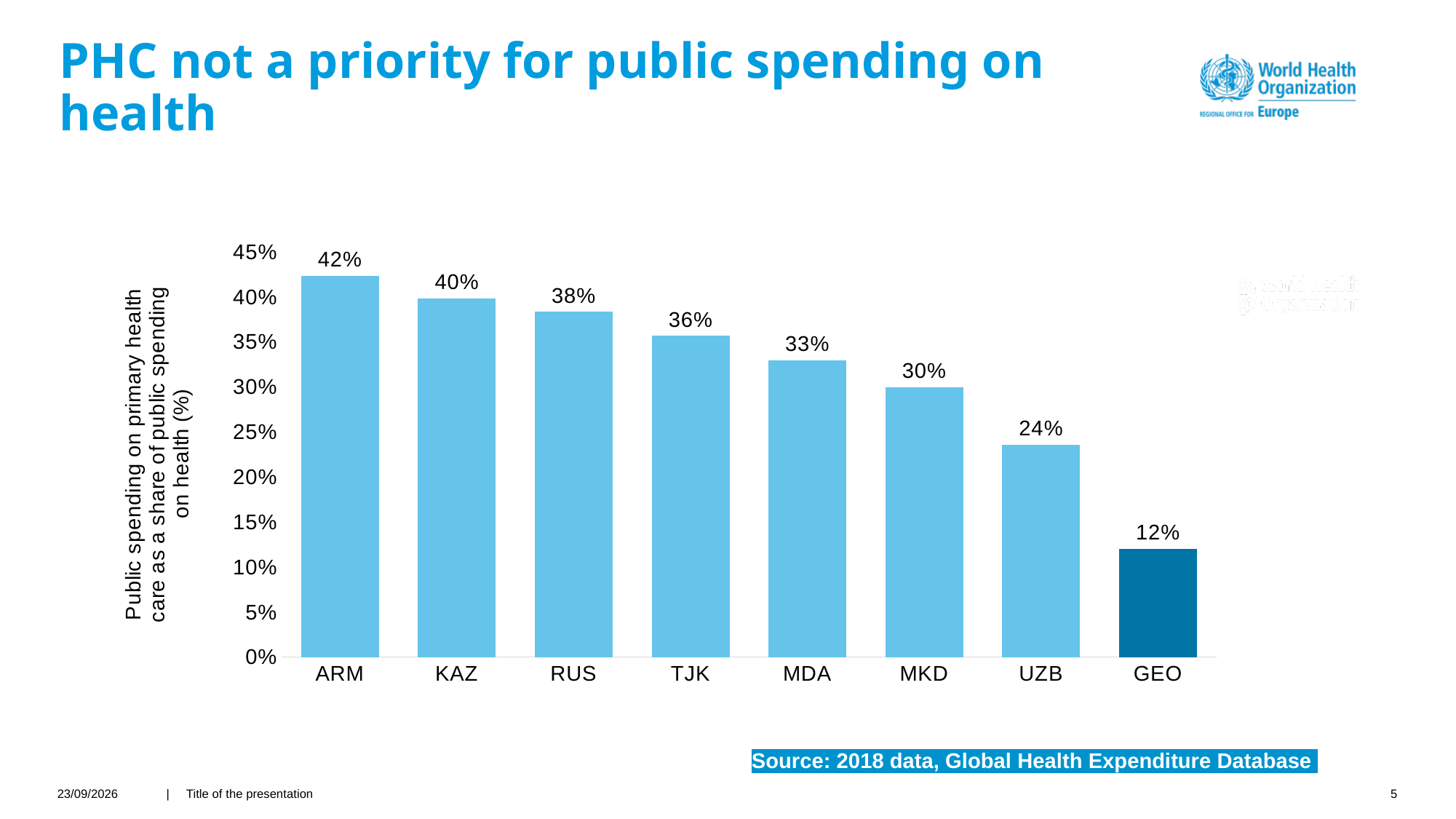
What kind of chart is shown on the slide? bar chart How many countries are shown on the chart? 8 Is the value for TJK greater or less than 35%? greater What is the value for MDA? 33% What is the value for GEO? 12% Which country has the highest value? ARM What is the difference between the values for KAZ and UZB? 16% What is the value for ARM? 42% Which country has the lowest value? GEO Which bar is shown in a darker blue than the others? GEO What is the difference between the values for ARM and GEO? 30% Which is larger, the value for RUS or the value for MKD? RUS